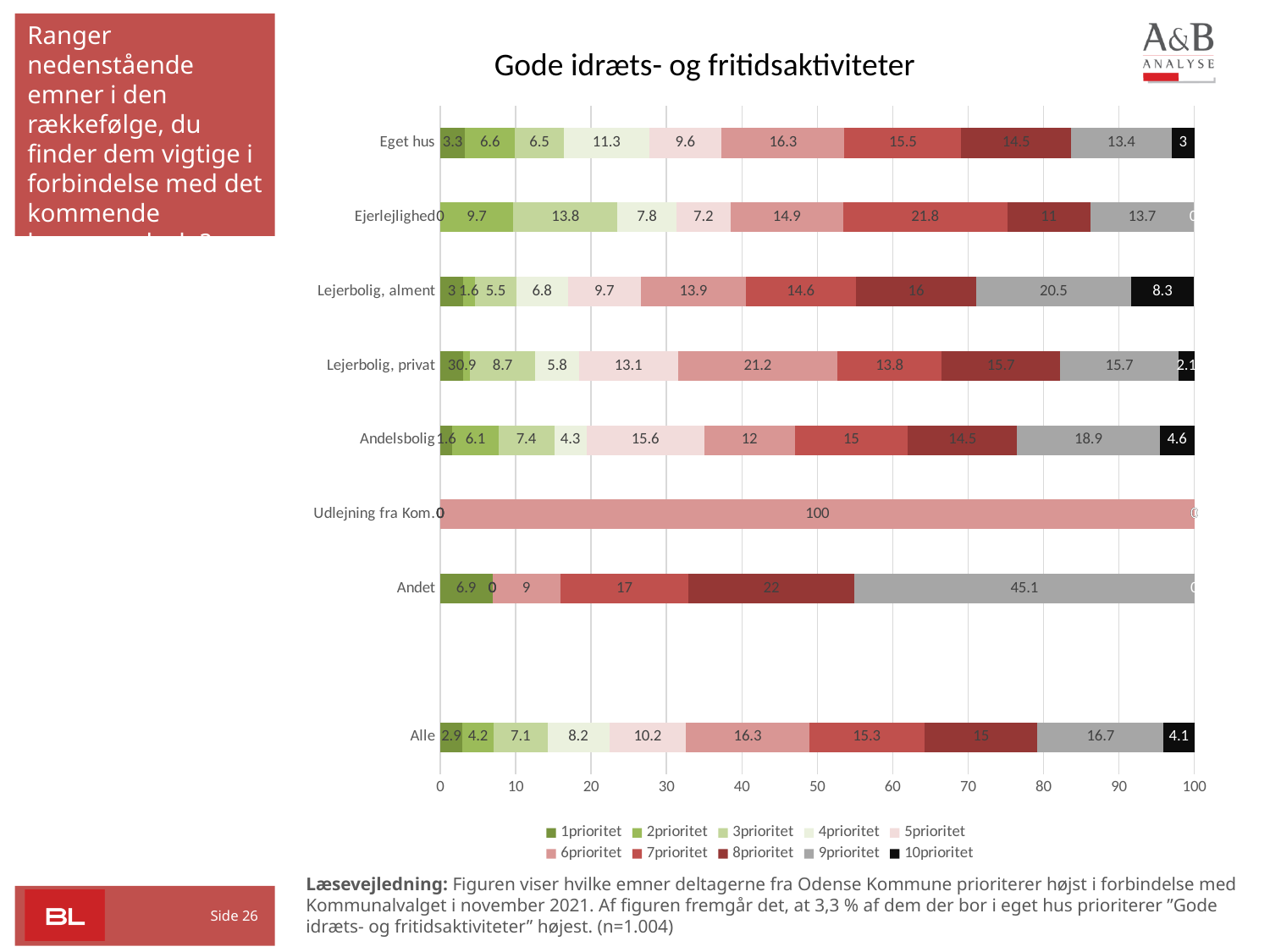
What is the value of 6prioritet for Udlejning fra Kom.? 100 What is the value of 9prioritet for Andet? 45.1 What is the title of the chart? Gode idræts- og fritidsaktiviteter Which category has the highest value for 10prioritet? Lejerbolig, alment How many series does the legend list? 10 What is the value of 10prioritet for Lejerbolig, alment? 8.3 How many categories are shown on the vertical axis of the chart? 8 What is the value of 1prioritet for Eget hus? 3.3 What is the difference between the 9prioritet values for Lejerbolig, alment and Alle? 3.8 What type of chart is shown on the slide? Stacked bar chart What is the value of 5prioritet for Andelsbolig? 15.6 Which is larger: the 7prioritet value for Ejerlejlighed or for Eget hus? Ejerlejlighed